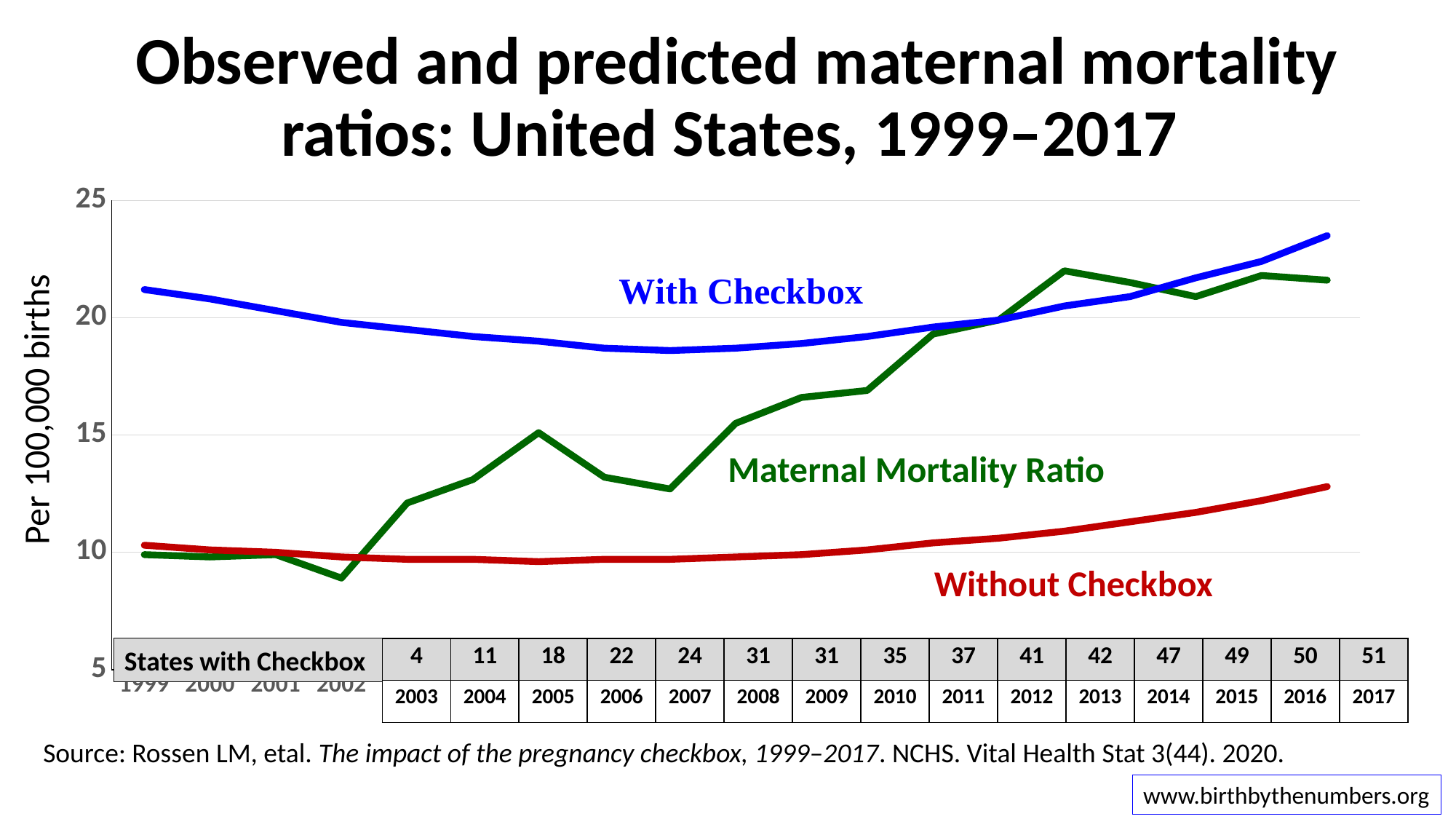
How many years are plotted along the x axis of the chart? 19 Does the Without Checkbox line rise or fall from 2007 to 2017? rise How many data series are plotted on the chart? 3 In 2013, which is higher: Maternal Mortality Ratio or With Checkbox? Maternal Mortality Ratio What kind of chart is shown on the slide? line chart What is the label on the y axis of the chart? Per 100,000 births Is the value for Maternal Mortality Ratio in 2002 greater or less than 10? less Is the value for Without Checkbox in 2017 greater or less than 10? greater Is the value for Maternal Mortality Ratio in 2013 greater or less than 20? greater In 2017, which is higher: With Checkbox or Maternal Mortality Ratio? With Checkbox